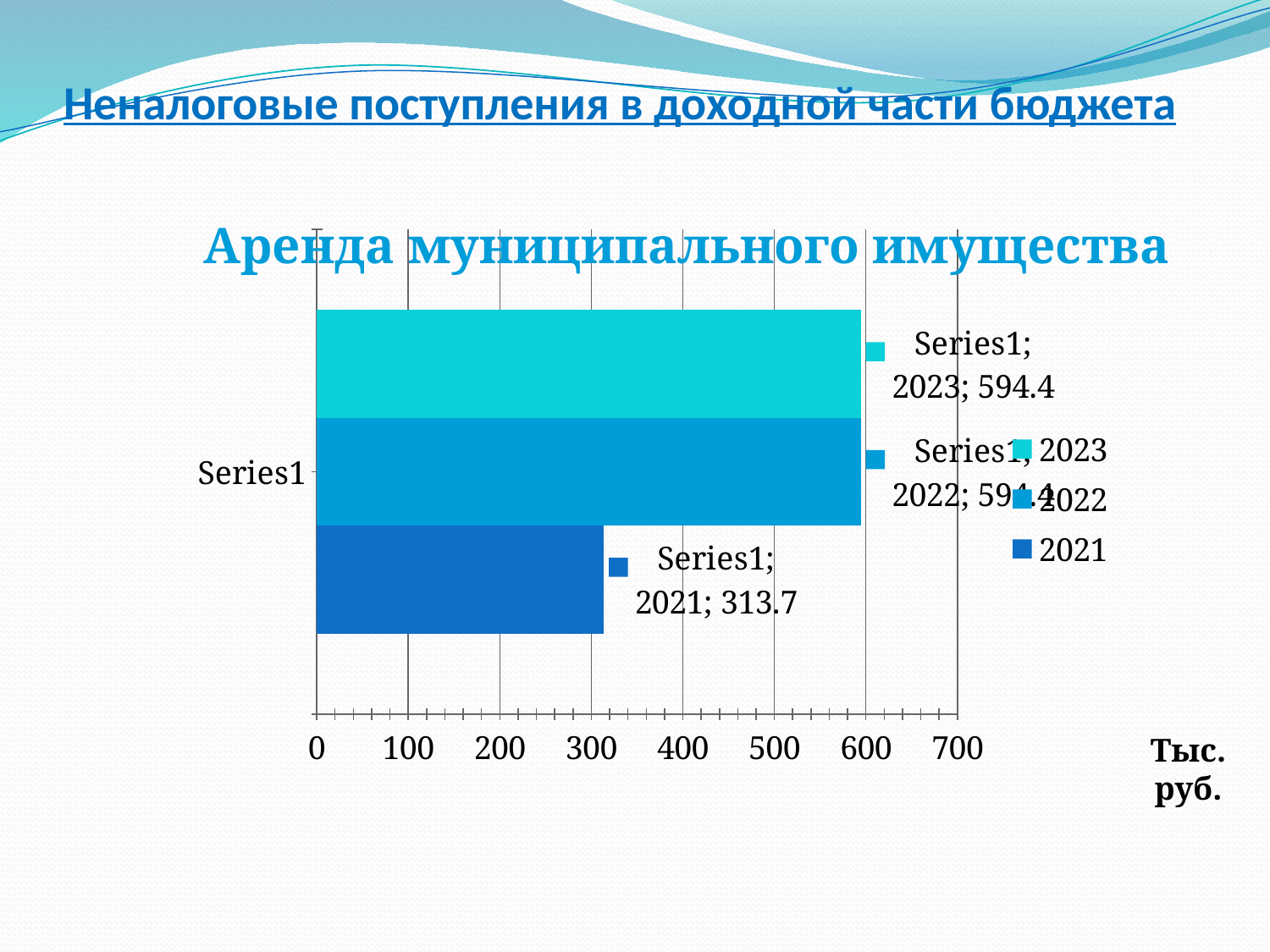
What kind of chart is shown on the slide? bar chart Is the value for 2022 greater or less than 500? greater What unit is shown next to the chart's axis? Тыс. руб. Which year has the lowest value in the chart? 2021 How many series does the legend list? 3 Is the value for 2023 greater or less than 700? less What is the difference between the value for 2023 and the value for 2021? 280.7 What is the value for 2023 in the chart? 594.4 What is the title of the chart? Аренда муниципального имущества Is the value for 2021 greater or less than 400? less Which is larger, the value for 2023 or the value for 2021? 2023 What is the value for 2021 in the chart? 313.7